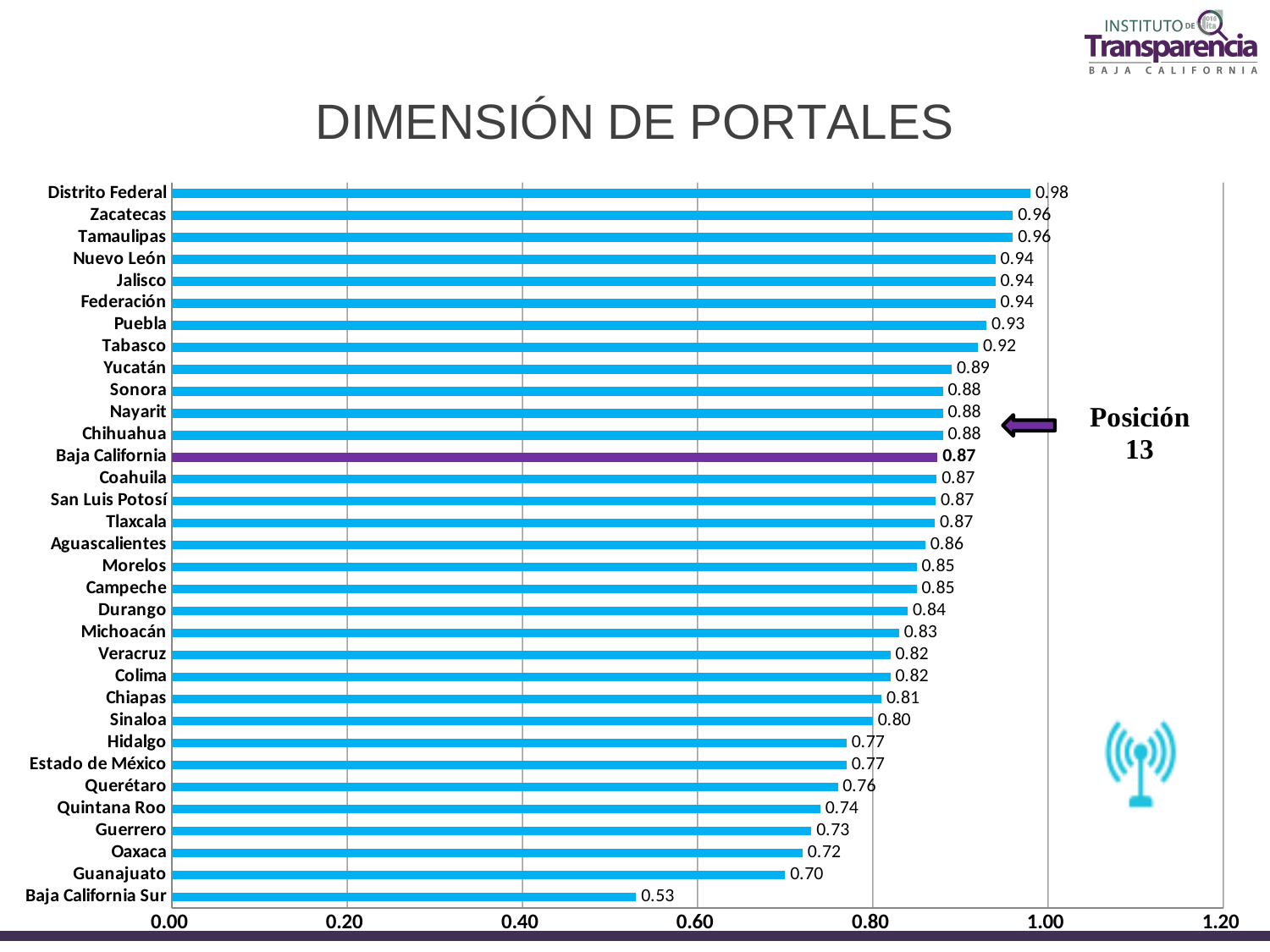
What is the value for Yucatán? 0.89 Which category has the highest value? Distrito Federal What is the value for Guanajuato? 0.70 What kind of chart is shown on the slide? Bar chart What is the title of the slide? DIMENSIÓN DE PORTALES How many categories are shown in the chart? 33 Which category has the lowest value? Baja California Sur Which is larger, the value for Tabasco or the value for Durango? Tabasco What is the difference between the values for Puebla and Sinaloa? 0.13 Is the value for Querétaro greater or less than 0.80? less What is the value for Baja California? 0.87 What is the difference between the values for Distrito Federal and Baja California Sur? 0.45